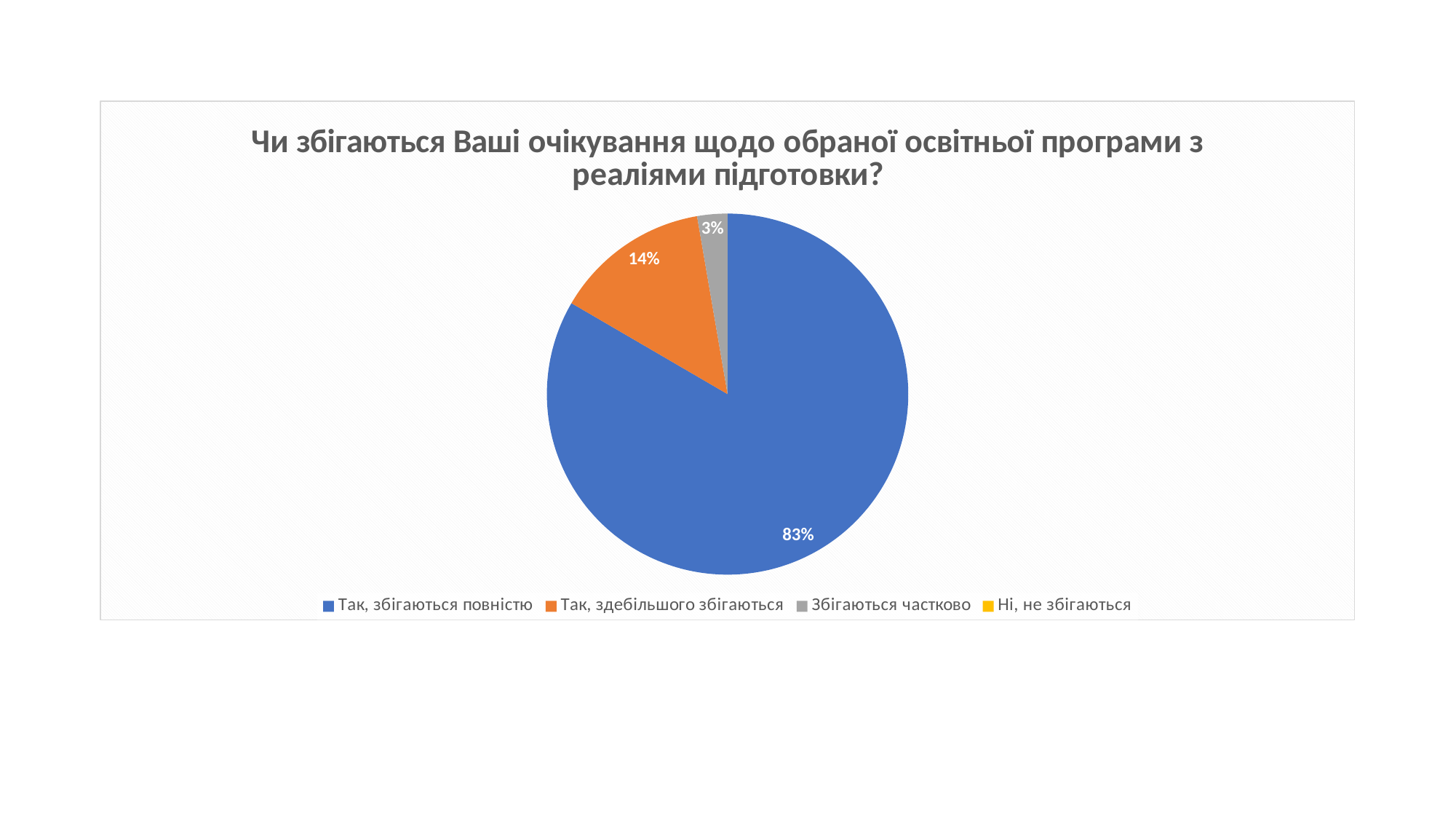
What is the difference in percentage points between "Так, збігаються повністю" and "Так, здебільшого збігаються"? 69 Which is larger: the share for "Так, здебільшого збігаються" or for "Збігаються частково"? Так, здебільшого збігаються What is the difference in percentage points between "Так, здебільшого збігаються" and "Збігаються частково"? 11 What is the value shown for "Збігаються частково"? 3% What kind of chart is shown on the slide? Pie chart Among the slices with printed values, which category has the smallest share? Збігаються частково What is the title of the chart? Чи збігаються Ваші очікування щодо обраної освітньої програми з реаліями підготовки? What is the value shown for "Так, здебільшого збігаються"? 14% What colour is the slice for "Так, здебільшого збігаються"? Orange What share of the pie does "Так, збігаються повністю" take? 83% Which category has the largest slice of the pie? Так, збігаються повністю How many entries does the legend list? 4